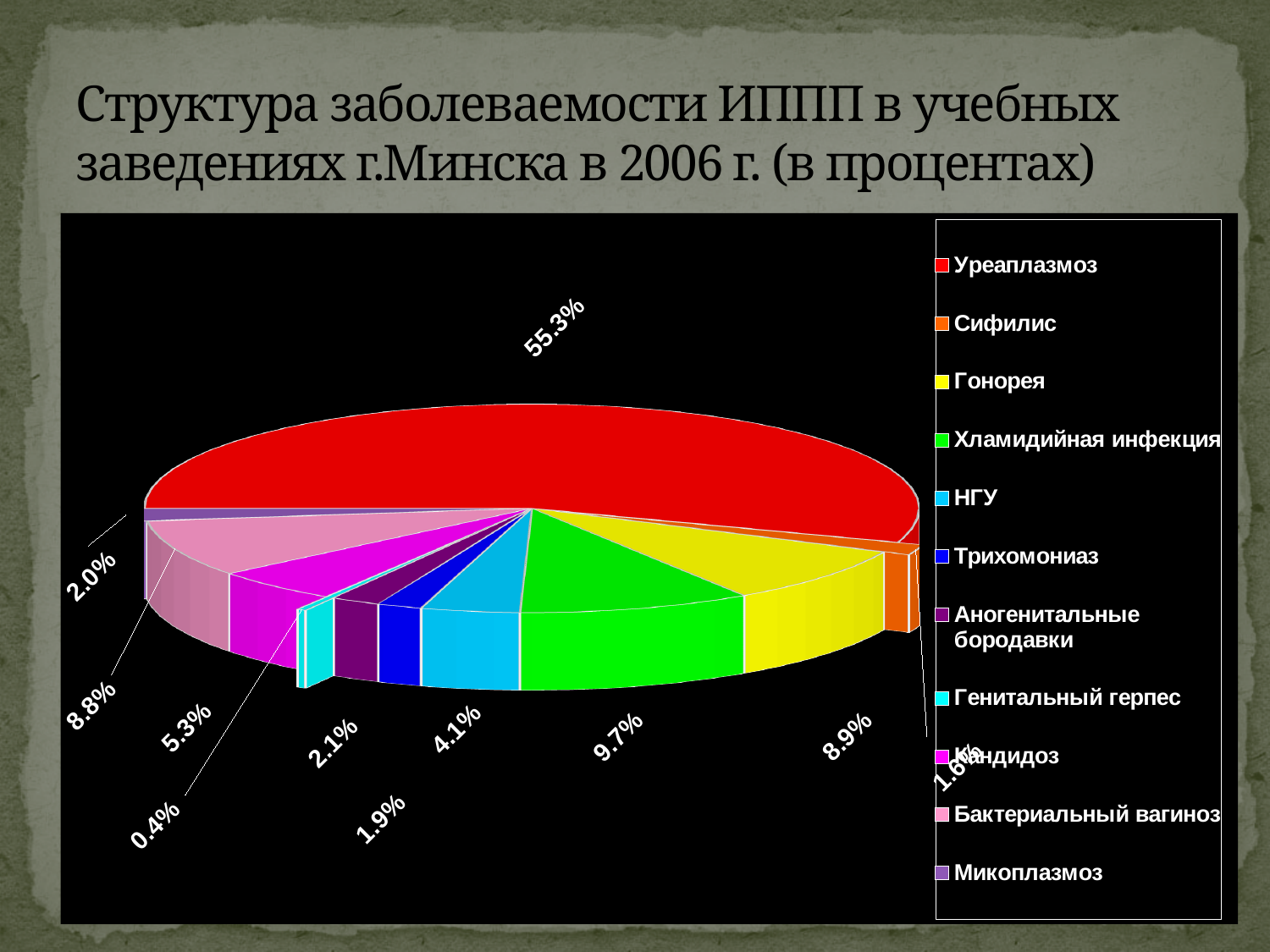
Which category has the smallest slice of the pie? Генитальный герпес What kind of chart is shown on the slide? pie chart What is the value shown for НГУ? 4.1% What is the difference between the values for Уреаплазмоз and Хламидийная инфекция? 45.6% Which is larger, the slice for Хламидийная инфекция or the slice for Бактериальный вагиноз? Хламидийная инфекция What share of the pie does Уреаплазмоз account for? 55.3% What is the value shown for Гонорея? 8.9% Which category has the largest slice of the pie? Уреаплазмоз What colour is the slice for Уреаплазмоз? red What is the value shown for Кандидоз? 5.3% How many categories does the legend of the pie chart list? 11 What is the value shown for Хламидийная инфекция? 9.7%